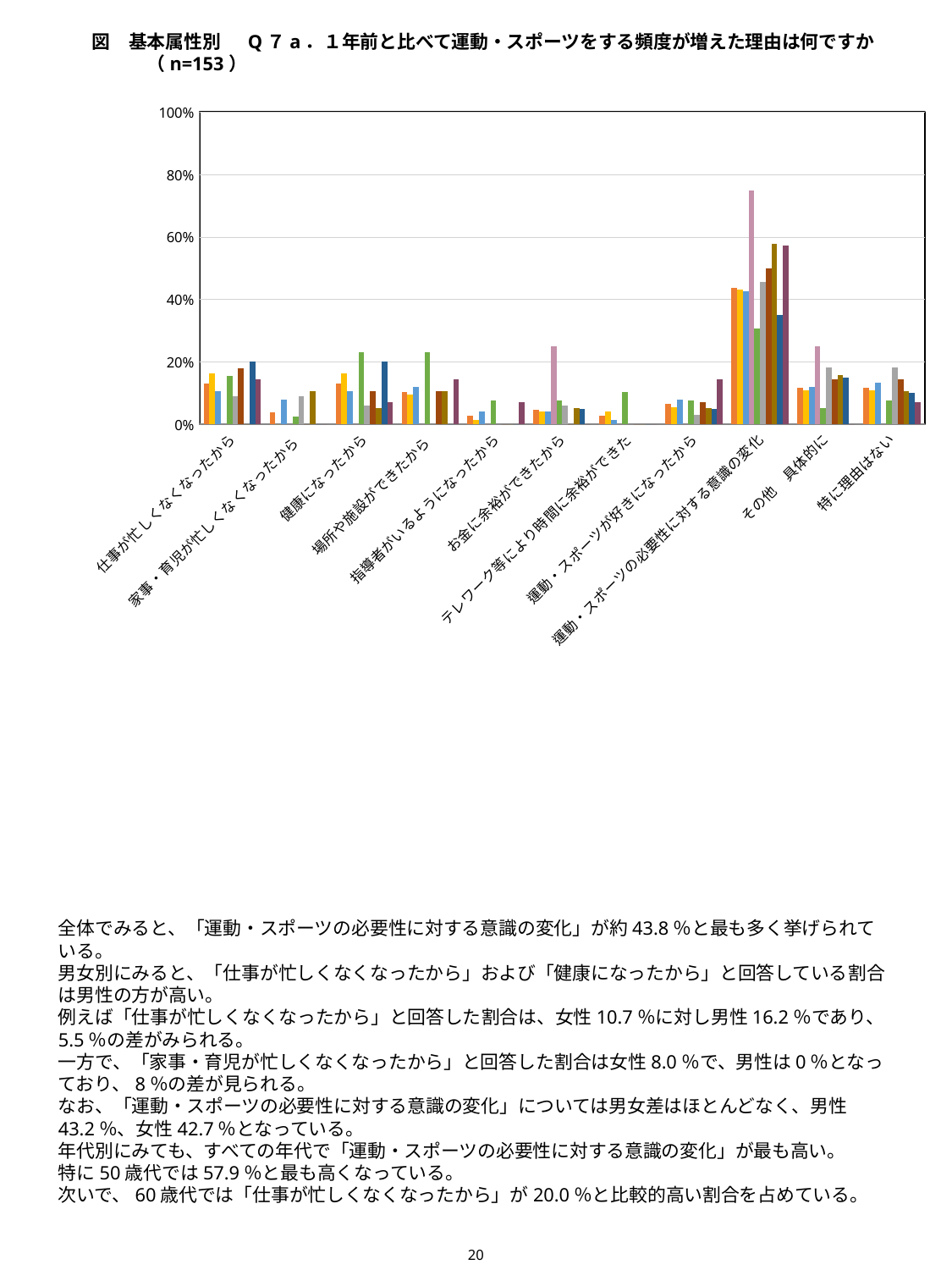
Which category has a taller maximum bar: 健康になったから or 指導者がいるようになったから? 健康になったから Is the tallest bar for テレワーク等により時間に余裕ができた greater or less than 20%? less What kind of chart is shown on the slide? bar chart Is the tallest bar for 指導者がいるようになったから greater or less than 20%? less What is the maximum value shown on the y axis of the chart? 100% Is the tallest bar for 仕事が忙しくなくなったから greater or less than 40%? less Which category has the tallest bars in the chart? 運動・スポーツの必要性に対する意識の変化 What sample size (n) is given in the chart title? n=153 Which category has a taller maximum bar: その他 具体的に or 特に理由はない? その他 具体的に How many categories are shown on the x axis of the chart? 11